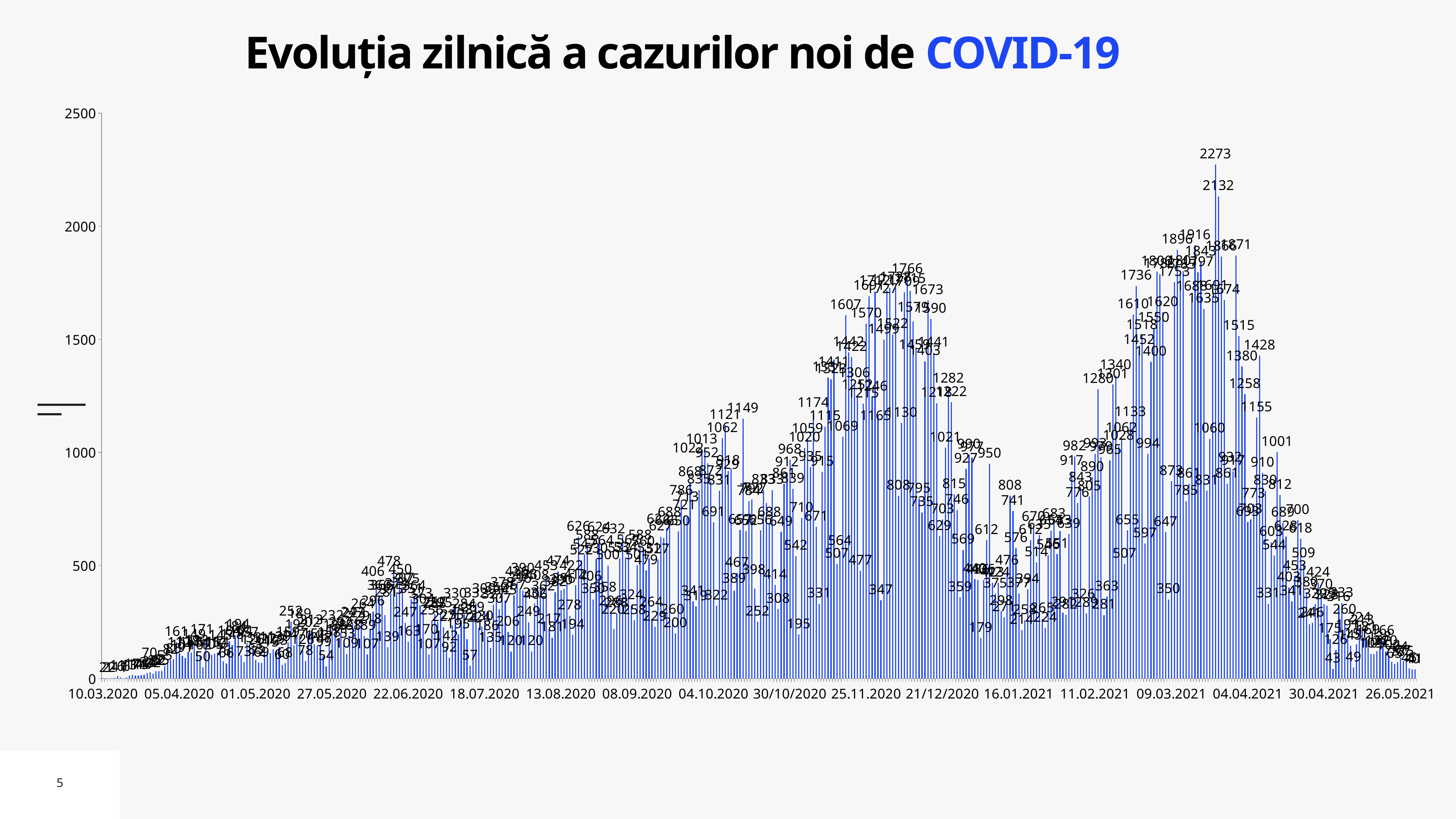
What is the highest tick value shown on the vertical axis? 2500 What is the last date label on the horizontal axis? 26.05.2021 What is the highest daily value labelled on the chart? 2273 Which is larger: the peak labelled 2273 in April 2021 or the peak labelled 1766 in November 2020? 2273 What kind of chart is shown on the slide? bar chart Do the daily values rise or fall between 10.03.2020 and 05.04.2020? rise What is the first date label on the horizontal axis? 10.03.2020 What is the title of the chart? Evoluția zilnică a cazurilor noi de COVID-19 Is the highest bar on the chart greater or less than 2000? greater Are the bars around 05.04.2020 greater or less than 500? less What is the second-highest daily value labelled on the chart, next to the 2273 peak? 2132 What is the difference between the two highest labelled values, 2273 and 2132? 141